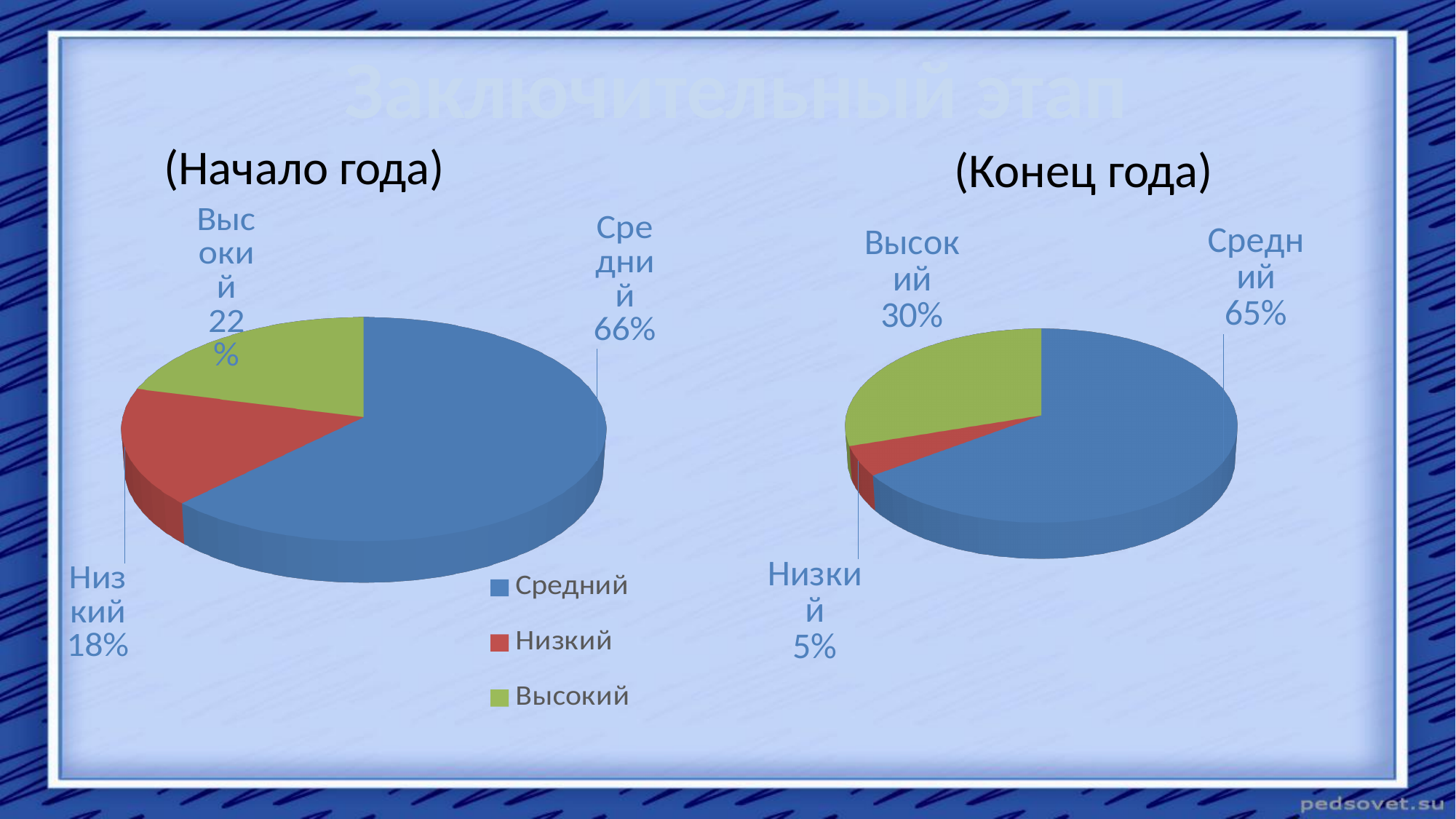
In the (Начало года) chart, what share does Средний have? 66% In the (Конец года) chart, what share does Высокий have? 30% In the (Начало года) chart, what share does Низкий have? 18% In the (Конец года) chart, which category has the smallest slice? Низкий How many slices does the (Конец года) chart have? 3 In the (Начало года) chart, which category has the largest slice? Средний In the (Начало года) chart, which is larger: Высокий or Низкий? Высокий Which colour represents Низкий in the legend? Red What is the difference between the Низкий share in the (Начало года) chart and the Низкий share in the (Конец года) chart? 13% What type of chart is the (Начало года) chart? Pie chart What is the difference between the Высокий share in the (Конец года) chart and the Высокий share in the (Начало года) chart? 8% In the (Конец года) chart, what share does Низкий have? 5%